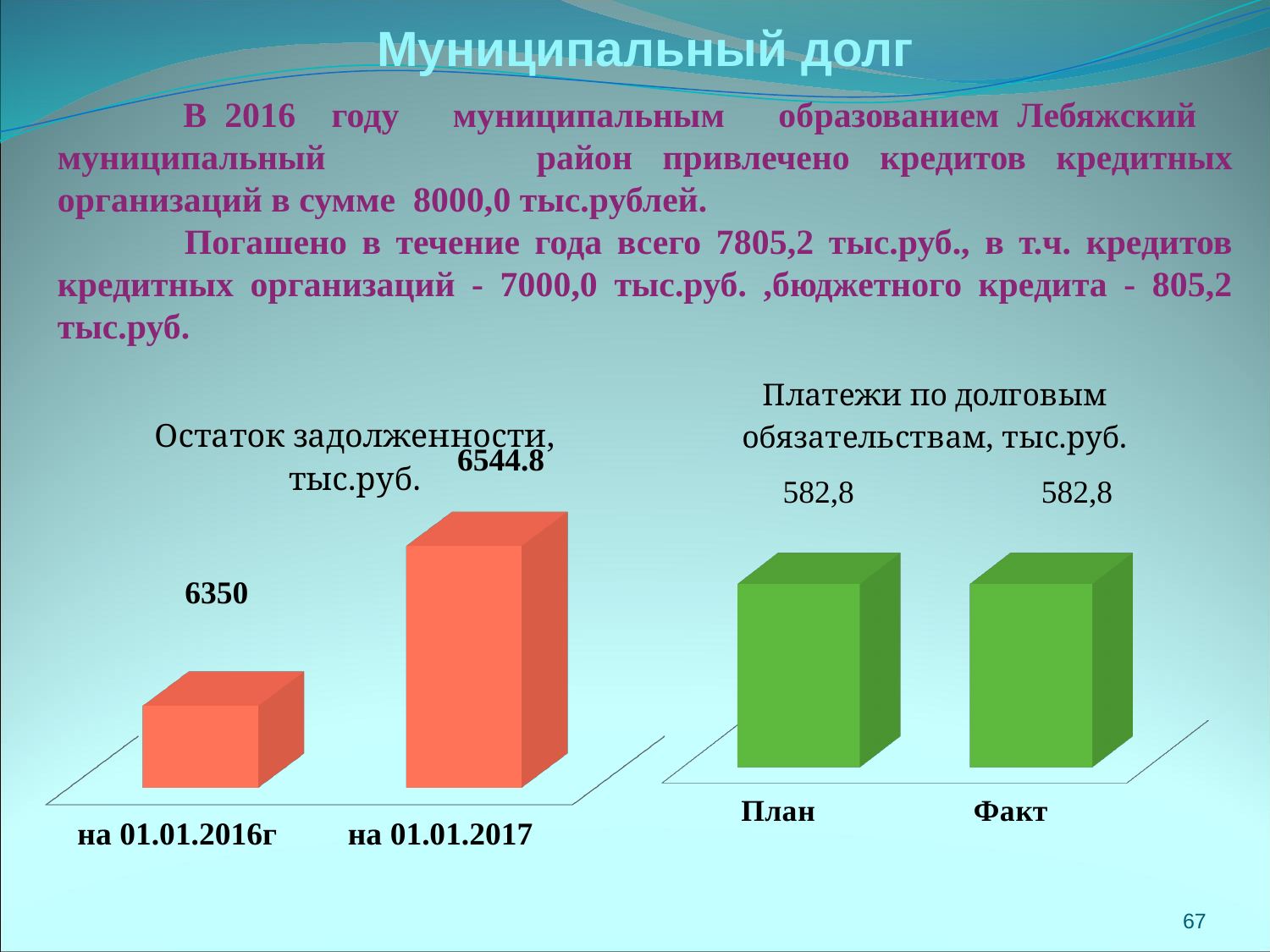
In the chart 'Платежи по долговым обязательствам, тыс.руб.', what is the value for 'План'? 582,8 What type of chart is the chart 'Платежи по долговым обязательствам, тыс.руб.'? bar chart How many bars are in the chart 'Остаток задолженности, тыс.руб.'? 2 In the chart 'Остаток задолженности, тыс.руб.', what is the value for 'на 01.01.2016г'? 6350 In the chart 'Остаток задолженности, тыс.руб.', what is the value for 'на 01.01.2017'? 6544.8 In the chart 'Остаток задолженности, тыс.руб.', which category has the higher value? на 01.01.2017 In the chart 'Платежи по долговым обязательствам, тыс.руб.', what is the value for 'Факт'? 582,8 In the chart 'Остаток задолженности, тыс.руб.', what is the difference between the values for 'на 01.01.2017' and 'на 01.01.2016г'? 194.8 In the chart 'Платежи по долговым обязательствам, тыс.руб.', what is the difference between 'План' and 'Факт'? 0 What colour are the bars in the chart 'Платежи по долговым обязательствам, тыс.руб.'? green In the chart 'Остаток задолженности, тыс.руб.', do the values rise or fall from 'на 01.01.2016г' to 'на 01.01.2017'? rise In the chart 'Остаток задолженности, тыс.руб.', which category has the lower value? на 01.01.2016г